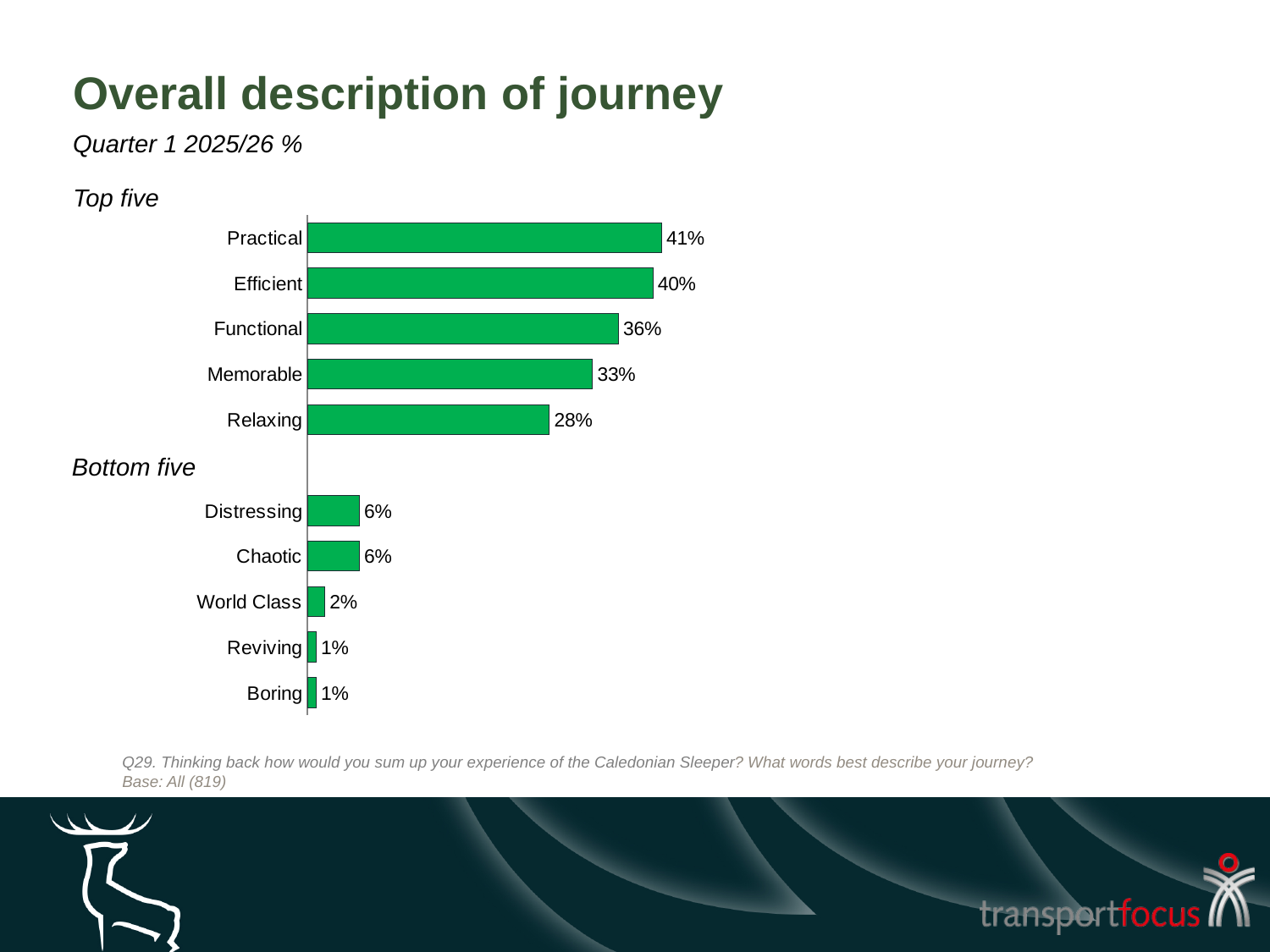
What is the difference between the values for Functional and Memorable? 3% What percentage of respondents described their journey as Practical? 41% Which has a larger value, Efficient or Functional? Efficient Which description in the Top five has the lowest value? Relaxing What is the value shown for World Class? 2% What is the base size stated below the chart? 819 What is the value shown for Relaxing? 28% What kind of chart is shown on the slide? Bar chart Which has a larger value, Distressing or World Class? Distressing Which description has the highest value on the chart? Practical How many descriptions are plotted on the chart in total? 10 What is the difference between the values for Practical and Relaxing? 13%